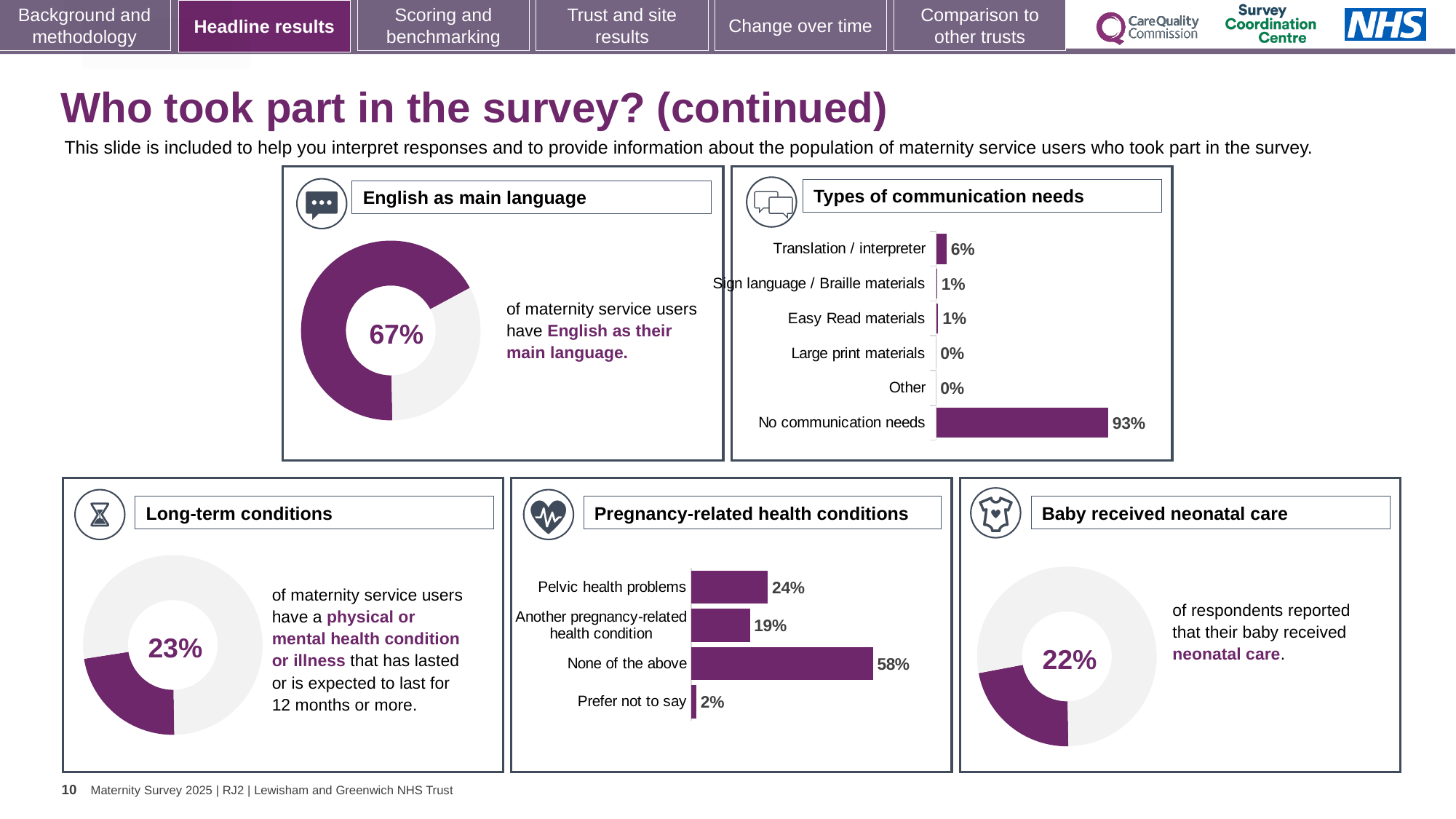
In the 'Pregnancy-related health conditions' chart, what is the difference between None of the above and Pelvic health problems? 34% In the 'Long-term conditions' chart, what percentage of maternity service users have a long-term physical or mental health condition? 23% What kind of chart is used in the 'Pregnancy-related health conditions' panel? Bar chart In the 'Types of communication needs' chart, what is the difference between No communication needs and Translation / interpreter? 87% In the 'Baby received neonatal care' chart, what percentage of respondents reported their baby received neonatal care? 22% In the 'Pregnancy-related health conditions' chart, which is larger: Pelvic health problems or Another pregnancy-related health condition? Pelvic health problems In the 'Types of communication needs' chart, how many categories are shown? 6 In the 'Types of communication needs' chart, which category has the highest value? No communication needs In the 'English as main language' chart, what percentage of maternity service users have English as their main language? 67% In the 'Types of communication needs' chart, what is the value for Translation / interpreter? 6% In the 'Pregnancy-related health conditions' chart, which category has the lowest value? Prefer not to say In the 'Pregnancy-related health conditions' chart, what is the value for Pelvic health problems? 24%